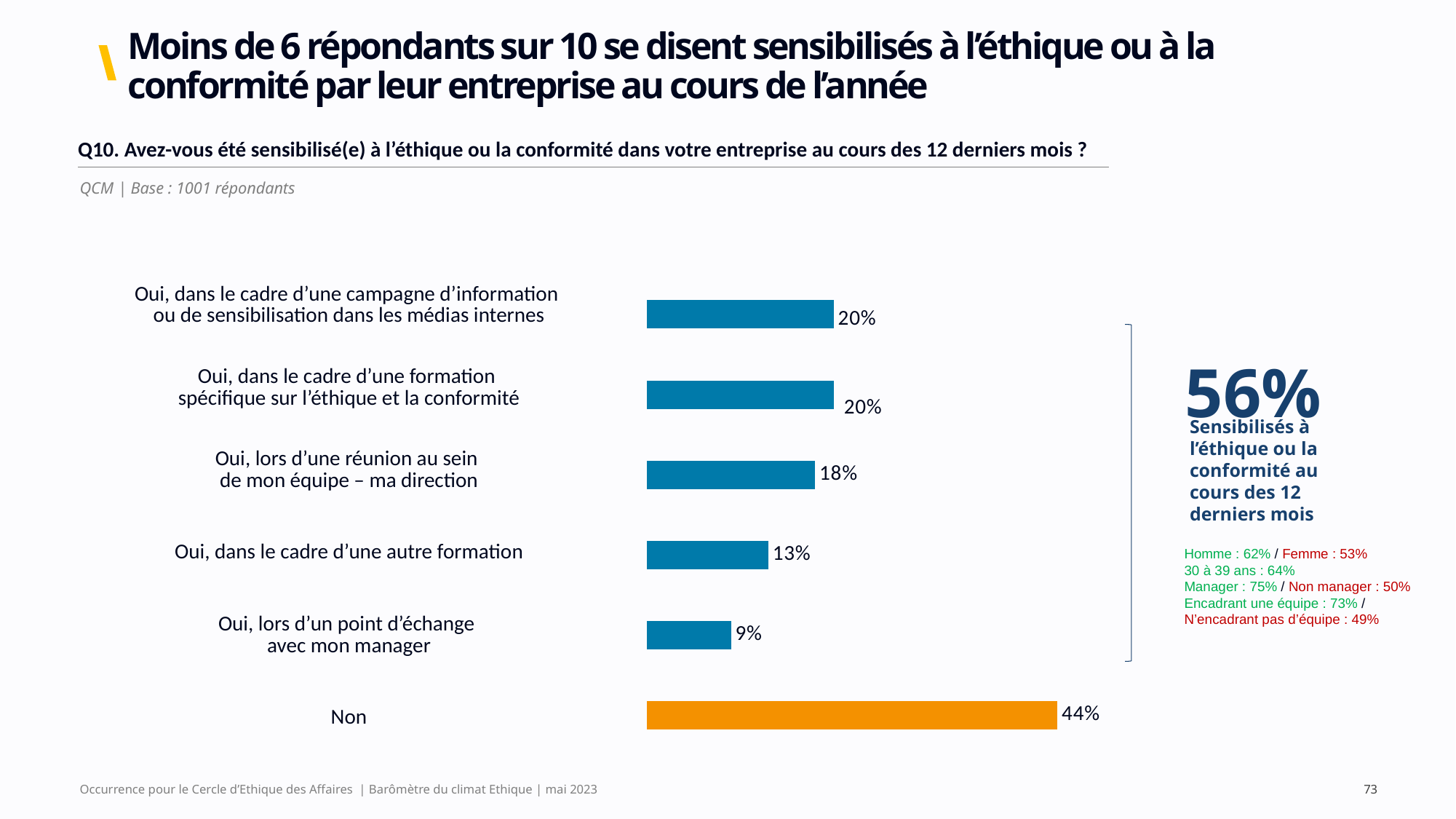
What percentage of respondents were sensitised to ethics or compliance in the last 12 months, according to the large figure on the right? 56% What is the difference between the value for "Non" and the value for "Oui, dans le cadre d'une autre formation"? 31% Which category has the lowest value? Oui, lors d'un point d'échange avec mon manager What is the value for "Oui, lors d'un point d'échange avec mon manager"? 9% Which category has the highest value? Non How many categories are shown in the bar chart? 6 What is the value for "Oui, dans le cadre d'une autre formation"? 13% What is the value for "Oui, lors d'une réunion au sein de mon équipe – ma direction"? 18% What colour is the bar for "Non"? Orange Which is larger: the value for "Oui, lors d'une réunion au sein de mon équipe – ma direction" or the value for "Oui, dans le cadre d'une autre formation"? Oui, lors d'une réunion au sein de mon équipe – ma direction What kind of chart is shown on the slide? Bar chart What is the value for "Non"? 44%